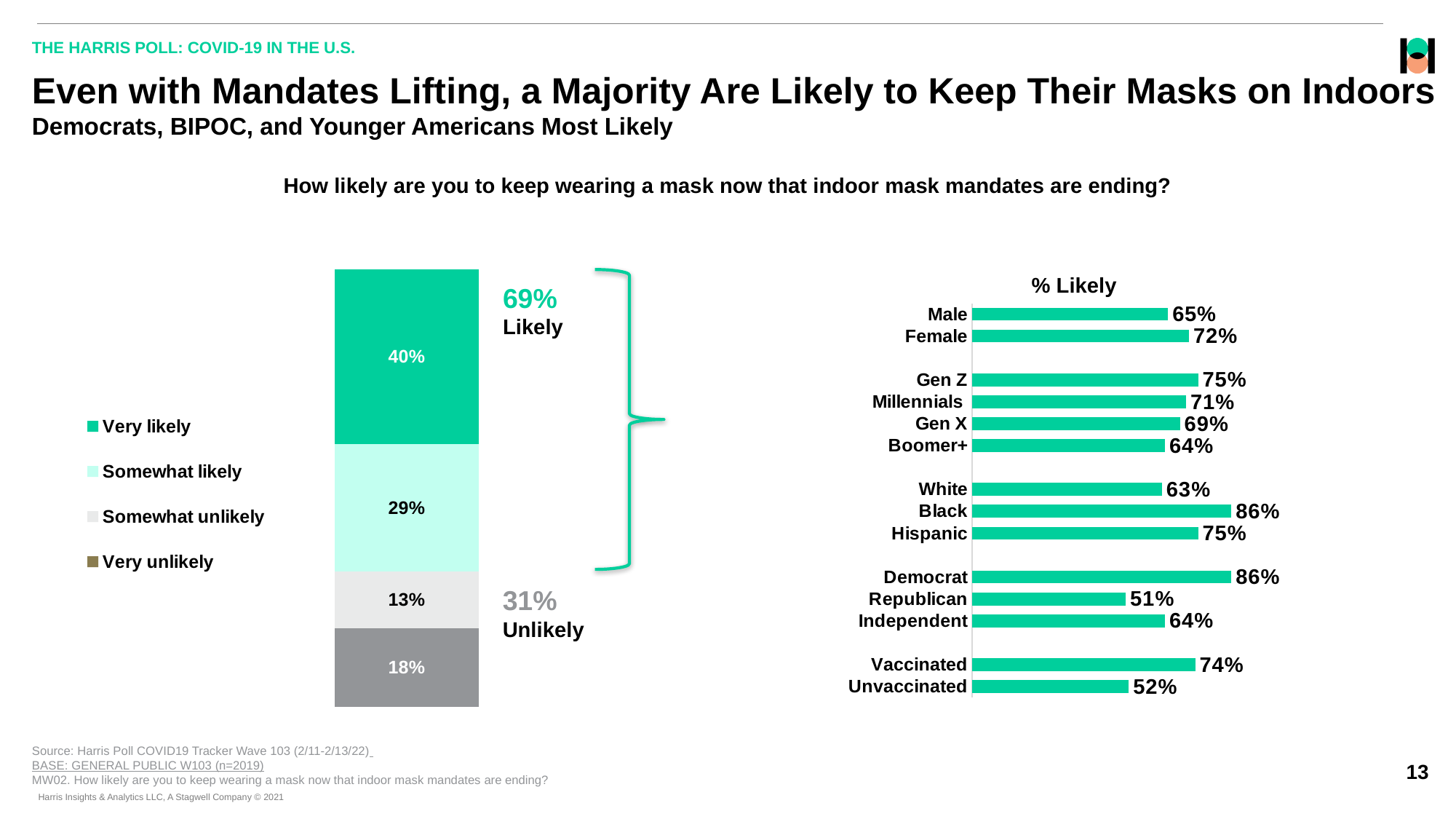
In the '% Likely' chart on the right, which is larger, Gen Z or Boomer+? Gen Z In the '% Likely' chart on the right, what is the value for Unvaccinated? 52% In the stacked bar chart on the left, what is the combined 'Likely' total shown next to the bar? 69% In the '% Likely' chart on the right, what is the difference between Vaccinated and Unvaccinated? 22% In the '% Likely' chart on the right, which category has the lowest value? Republican In the stacked bar chart on the left, how many series does the legend list? 4 In the '% Likely' chart on the right, what is the value for Republican? 51% In the '% Likely' chart on the right, how many categories are plotted? 14 What kind of chart is the '% Likely' chart on the right? Bar chart In the stacked bar chart on the left, what percentage is shown for 'Somewhat unlikely'? 13% In the '% Likely' chart on the right, what is the difference between Female and Male? 7% In the stacked bar chart on the left, what percentage is shown for 'Very likely'? 40%